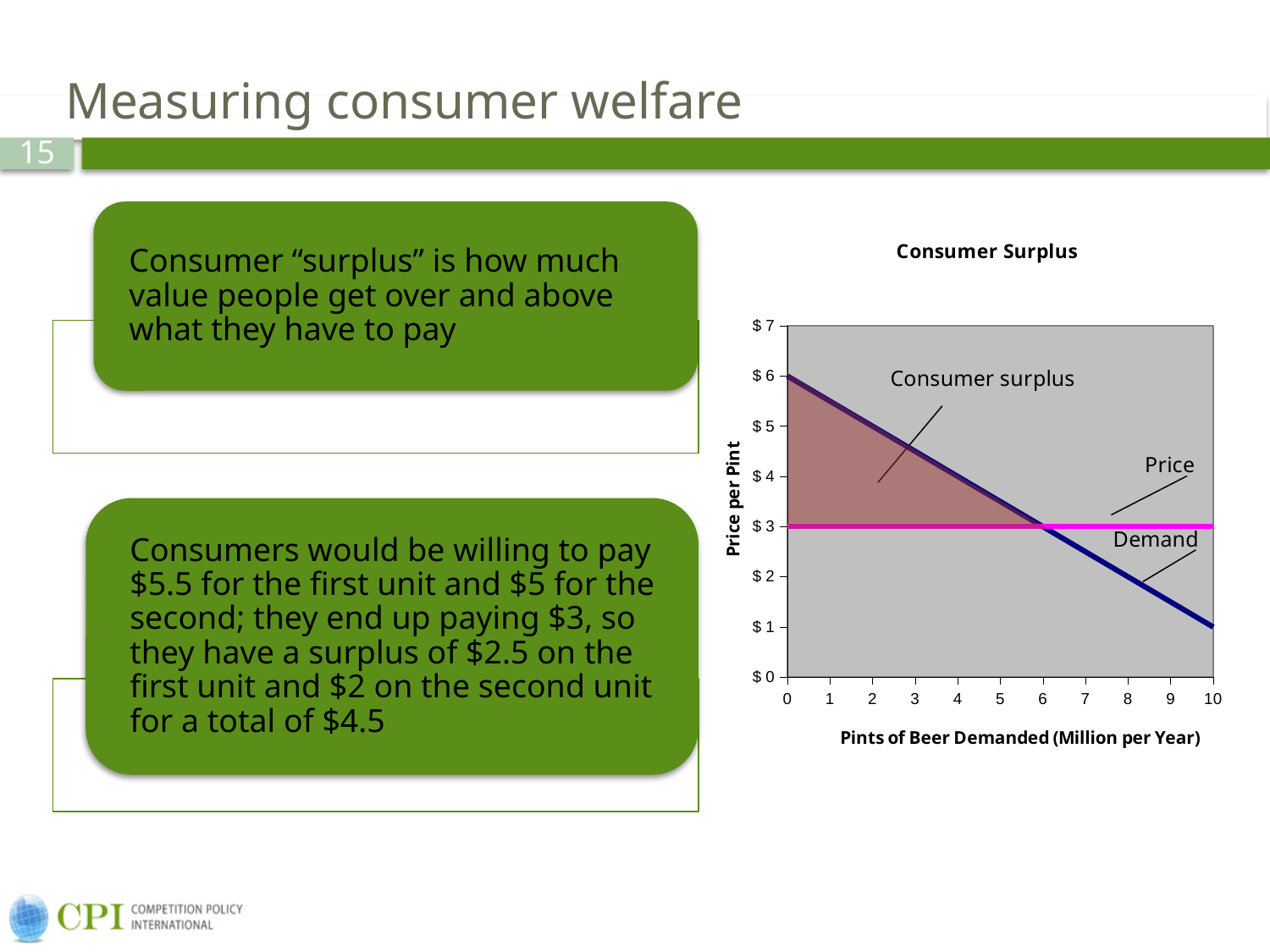
What is the price shown by the horizontal Price line? $3 What type of chart is shown on the slide? line chart At how many million pints per year does the Demand line cross the Price line? 6 Is the value of the Demand line at 8 pints greater or less than $3? less What is the title of the chart? Consumer Surplus Does the Demand line rise or fall as pints of beer demanded increase? fall What is the label of the vertical axis of the chart? Price per Pint What is the difference between the Demand line's value at 0 pints and its value at 10 pints? $5 Which is higher at 4 pints demanded, the Demand line or the Price line? Demand Is the value of the Demand line at 2 pints greater or less than $4? greater What is the value of the Demand line at 0 pints of beer demanded? $6 What is the value of the Demand line at 10 pints of beer demanded? $1